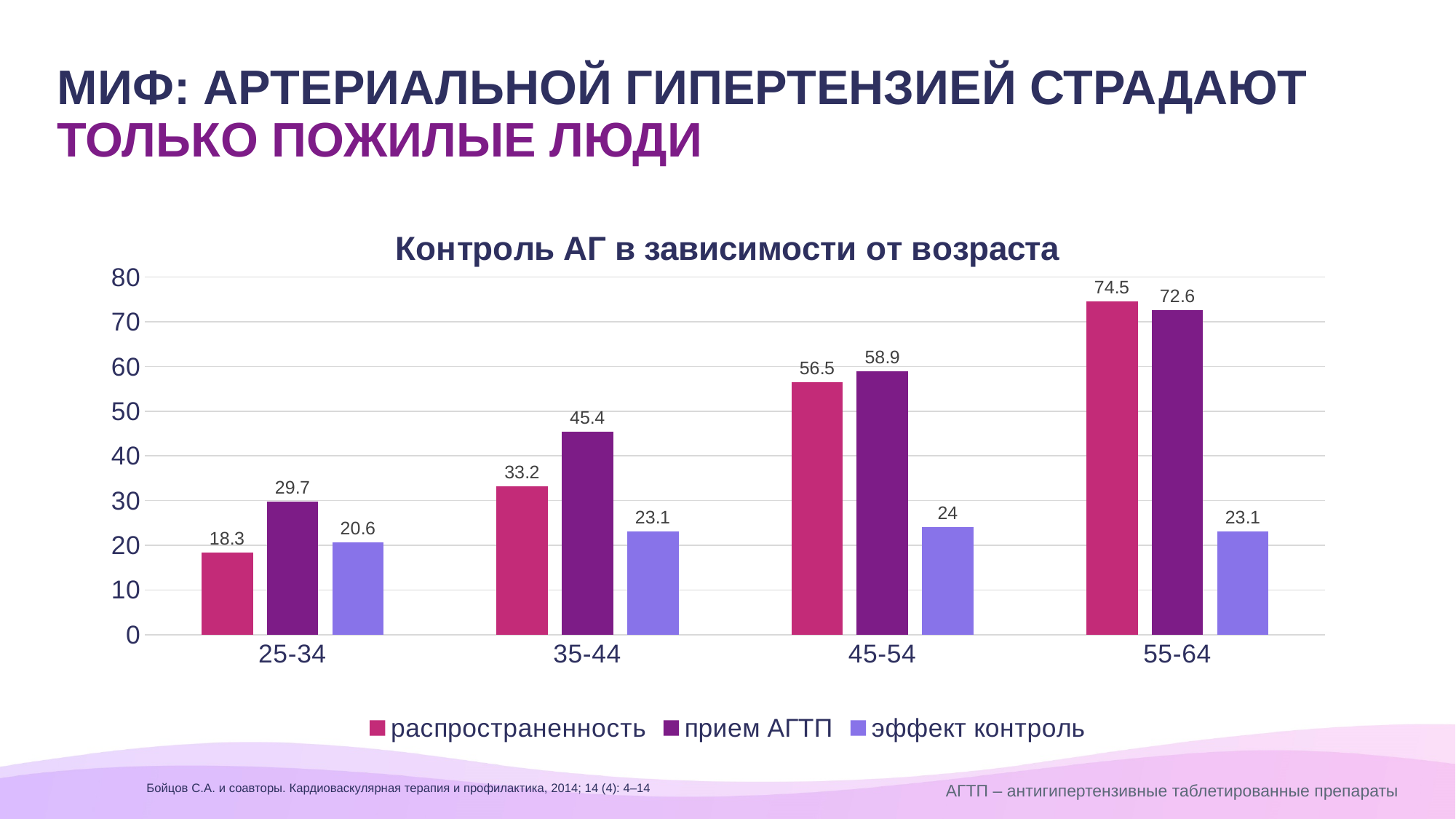
Which is larger for the 35-44 age group: распространенность or прием АГТП? прием АГТП Which age group has the highest value for распространенность? 55-64 How many age groups are shown on the x axis? 4 What is the value of распространенность for the 25-34 age group? 18.3 Which age group has the lowest value for прием АГТП? 25-34 How many series does the legend list? 3 What kind of chart is shown on the slide? bar chart What is the value of прием АГТП for the 45-54 age group? 58.9 What is the value of эффект контроль for the 35-44 age group? 23.1 Is the value of прием АГТП for the 45-54 age group greater or less than 50? greater What is the difference between распространенность and прием АГТП for the 55-64 age group? 1.9 Does the value of распространенность rise or fall as age increases along the x axis? rise